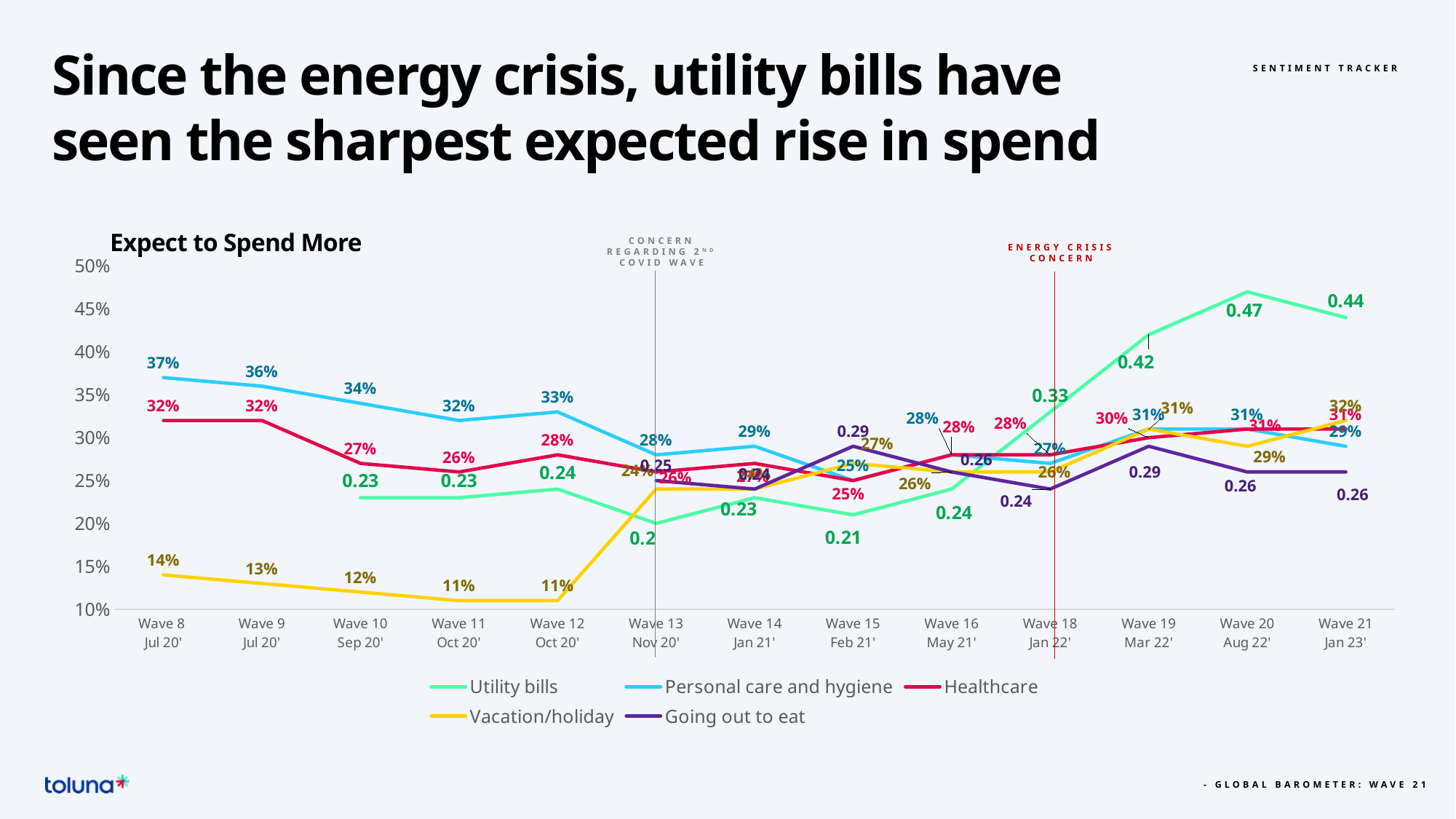
What is the value for Personal care and hygiene at Wave 8 Jul 20'? 37% What is the value for Healthcare at Wave 10 Sep 20'? 27% How many waves are shown along the x axis? 13 At which wave does Utility bills reach its highest value? Wave 20 Aug 22' Which series has the lowest value at Wave 8 Jul 20'? Vacation/holiday What is the difference between the Utility bills values at Wave 20 Aug 22' and Wave 21 Jan 23'? 0.03 At Wave 8 Jul 20', which is larger: Personal care and hygiene or Healthcare? Personal care and hygiene Does the Vacation/holiday line rise or fall from Wave 8 Jul 20' to Wave 12 Oct 20'? fall What is the value for Utility bills at Wave 20 Aug 22'? 0.47 What type of chart is shown on the slide? line chart How many series does the legend list? 5 What is the value for Vacation/holiday at Wave 11 Oct 20'? 11%